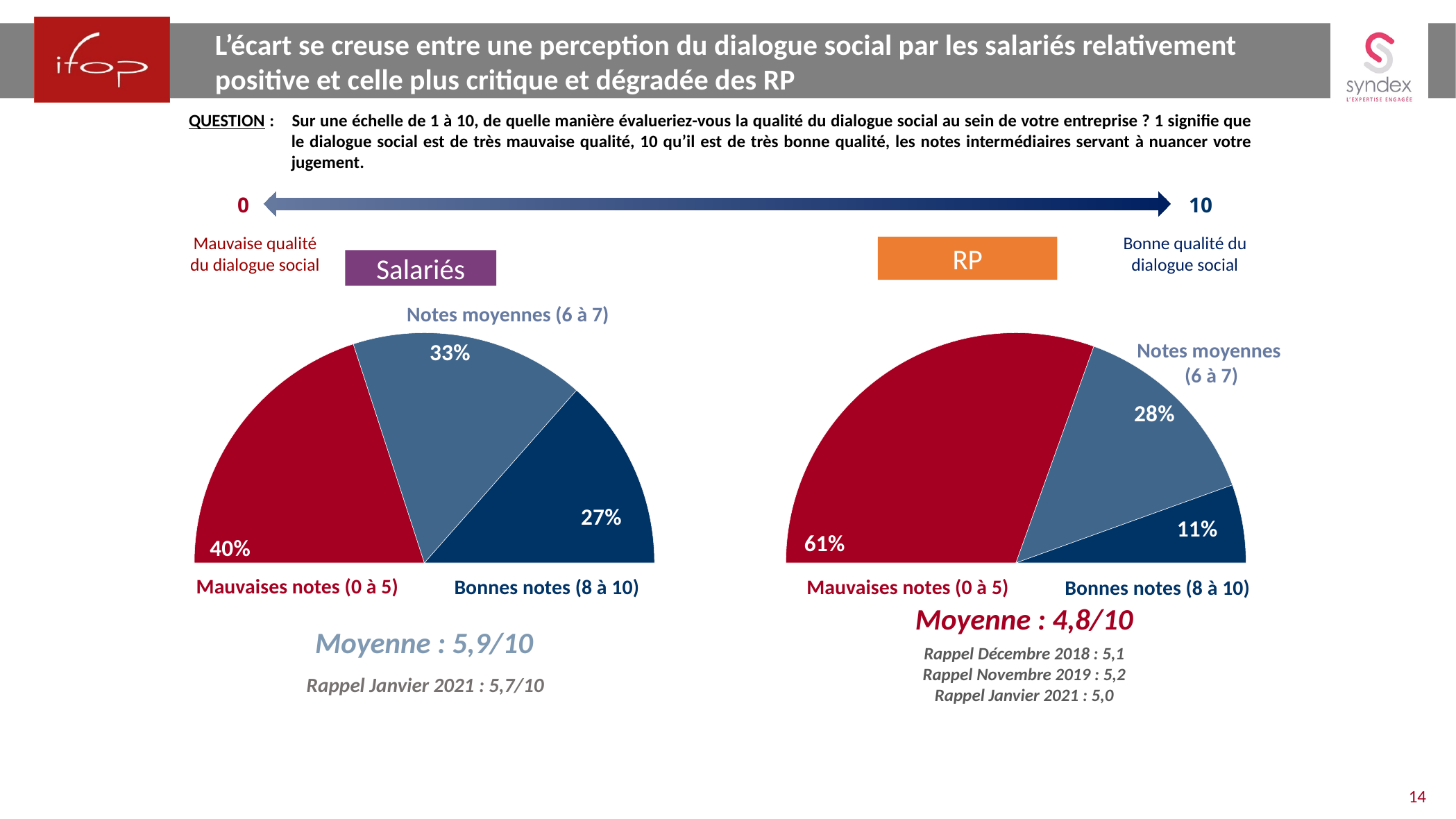
What is the difference between the Mauvaises notes (0 à 5) share in the RP chart and in the Salariés chart? 21 percentage points In the Salariés chart, which category has the smallest share? Bonnes notes (8 à 10) In the RP chart, what share is labelled for Bonnes notes (8 à 10)? 11% In the RP chart, which category has the smallest share? Bonnes notes (8 à 10) In the Salariés chart, what share is labelled for Notes moyennes (6 à 7)? 33% In the RP chart, which category has the largest share? Mauvaises notes (0 à 5) Which chart shows a larger share for Bonnes notes (8 à 10), Salariés or RP? Salariés In the Salariés chart, what is the difference between the Notes moyennes (6 à 7) share and the Bonnes notes (8 à 10) share? 6 percentage points What average score (Moyenne) is shown under the RP chart? 4,8/10 What kind of chart is used for the Salariés data? Pie chart (half pie) In the Salariés chart, what share is labelled for Mauvaises notes (0 à 5)? 40% How many categories does the Salariés chart show? 3